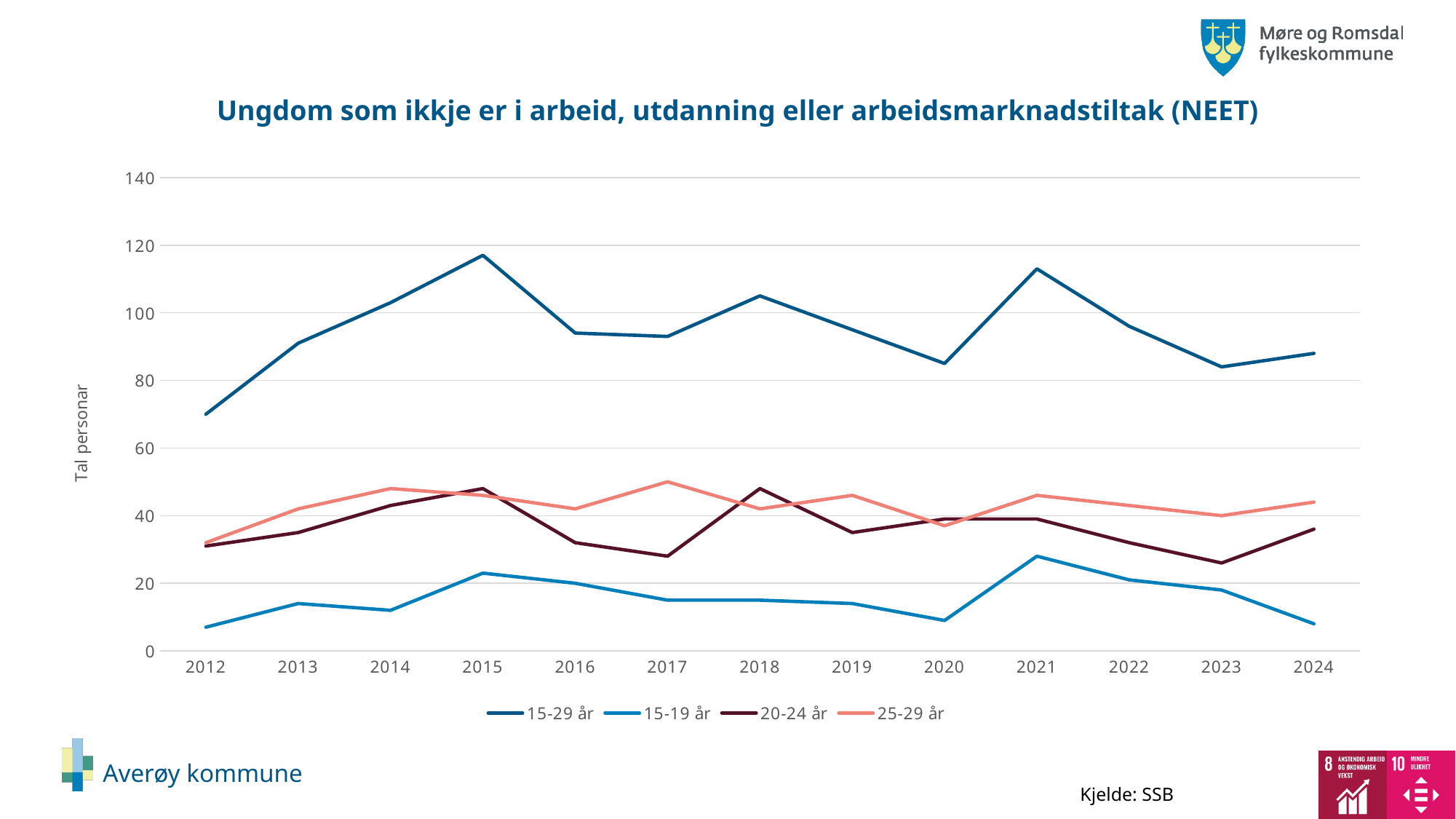
Is the value for 15-19 år in 2021 greater or less than 20? greater Is the value for 15-29 år in 2015 greater or less than 100? greater Which year has the highest value for the 15-19 år series? 2021 Which year has the lowest value for the 15-29 år series? 2012 Which is larger in 2017: the value for 20-24 år or the value for 25-29 år? 25-29 år How many series does the legend list? 4 What is the label on the y axis? Tal personar What kind of chart is shown on the slide? line chart How many years are shown along the x axis? 13 Which year has the lowest value for the 25-29 år series? 2012 Does the 15-29 år series rise or fall from 2012 to 2015? rise Is the value for 15-29 år in 2012 greater or less than 80? less